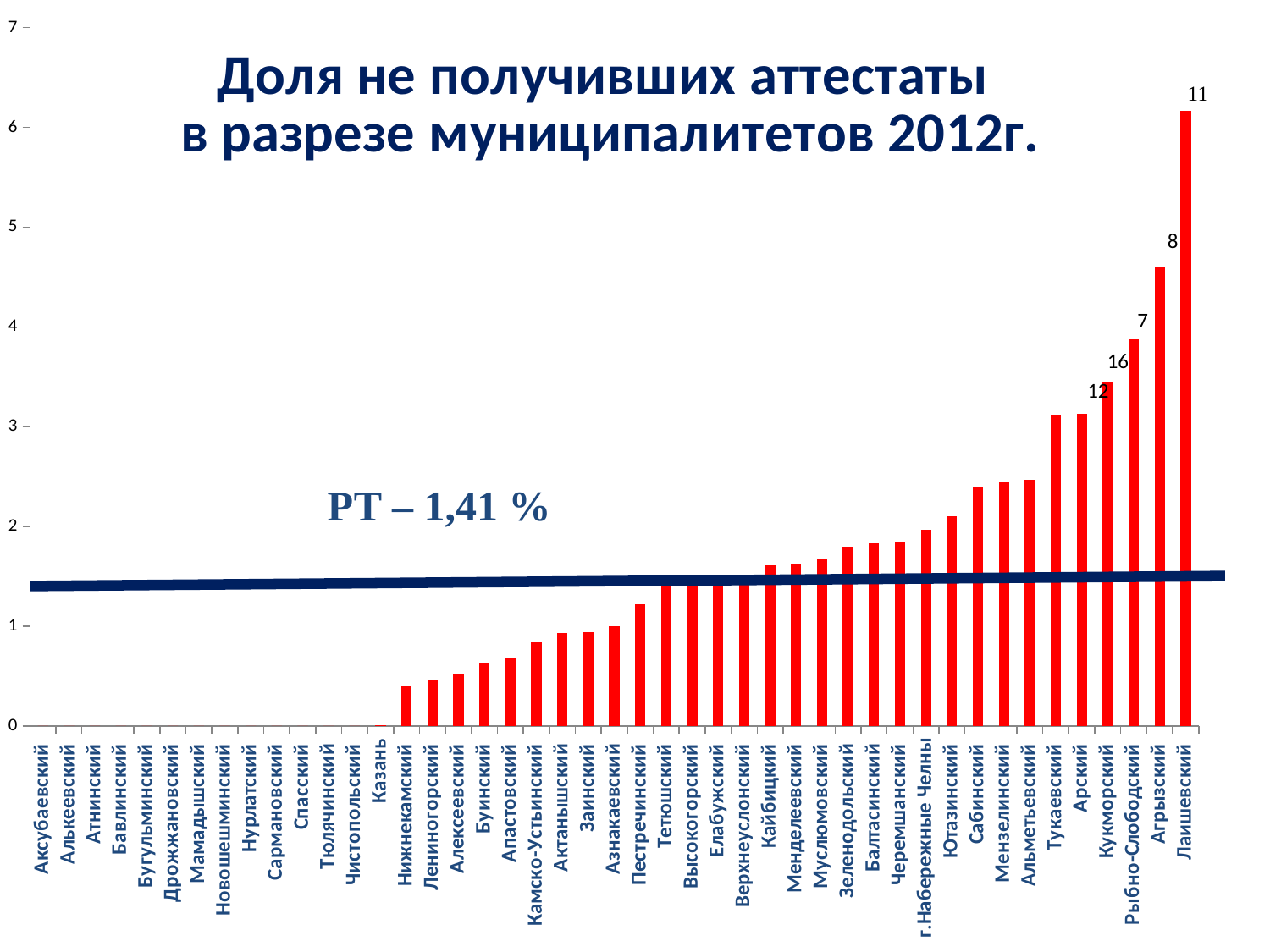
What kind of chart is shown on the slide? bar chart Is the value for Агрызский greater or less than 4? greater How many municipalities are listed on the x axis? 45 Which has the larger value, Агрызский or Рыбно-Слободский? Агрызский Is the value for Лаишевский greater or less than 6? greater What value is given for РТ on the chart? 1,41 % What is the title of the chart? Доля не получивших аттестаты в разрезе муниципалитетов 2012г. Is the value for Нижнекамский greater or less than 1? less Do the bar values rise or fall from left to right along the x axis? rise Which municipality has the highest bar? Лаишевский What number is printed above the bar for Лаишевский? 11